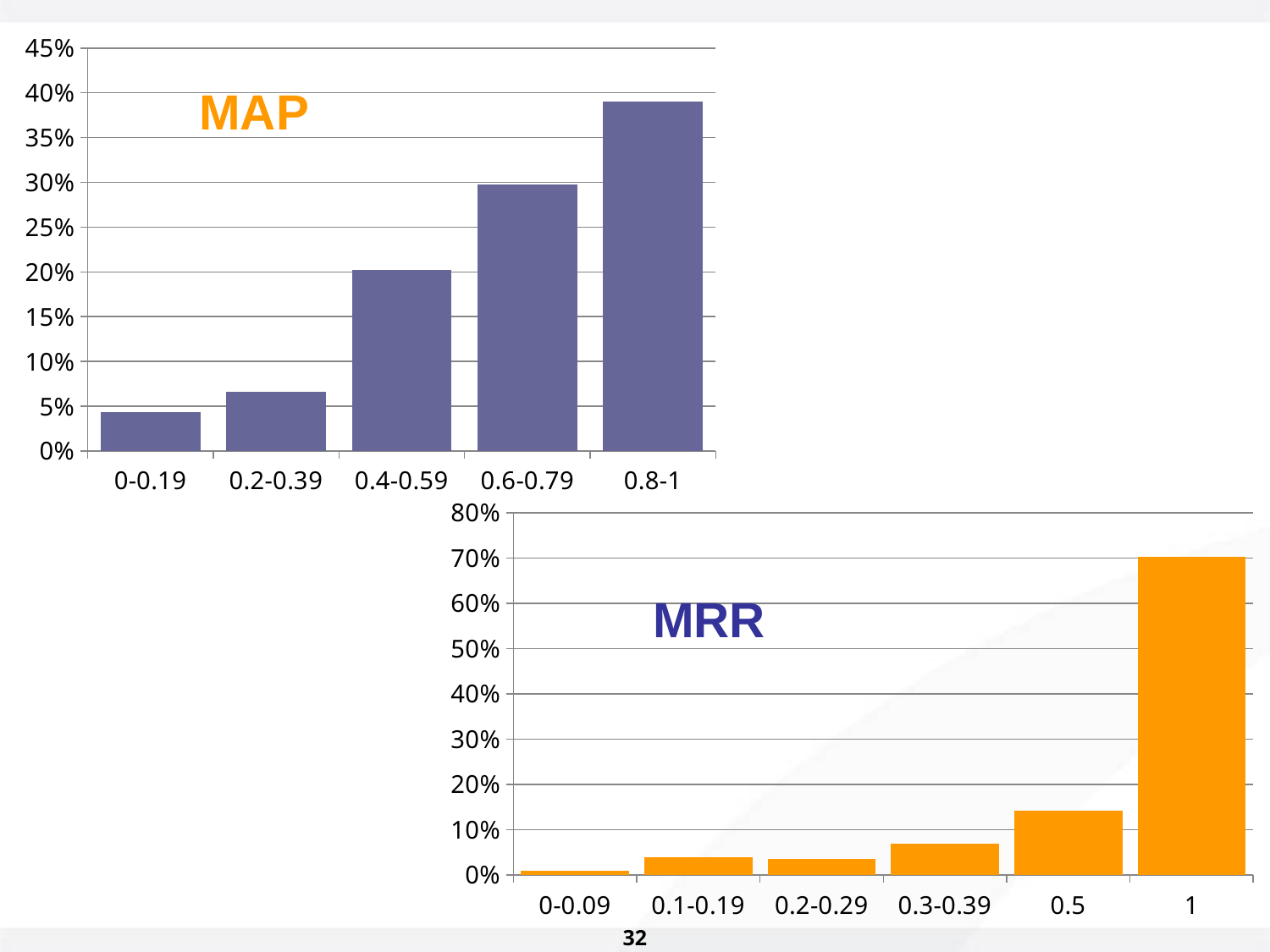
In the MAP chart, which category has the lowest value? 0-0.19 In the MRR chart, which category has the lowest value? 0-0.09 What kind of chart is the MAP chart? bar chart In the MRR chart, is the value for 0.5 greater or less than 10%? greater In the MRR chart, which category has the highest value? 1 How many categories are shown on the x axis of the MRR chart? 6 In the MAP chart, do the values rise or fall from left to right along the x axis? rise In the MAP chart, is the value for 0.8-1 greater or less than 35%? greater How many categories are shown on the x axis of the MAP chart? 5 In the MAP chart, is the value for 0.4-0.59 greater or less than 25%? less In the MAP chart, which category has the highest value? 0.8-1